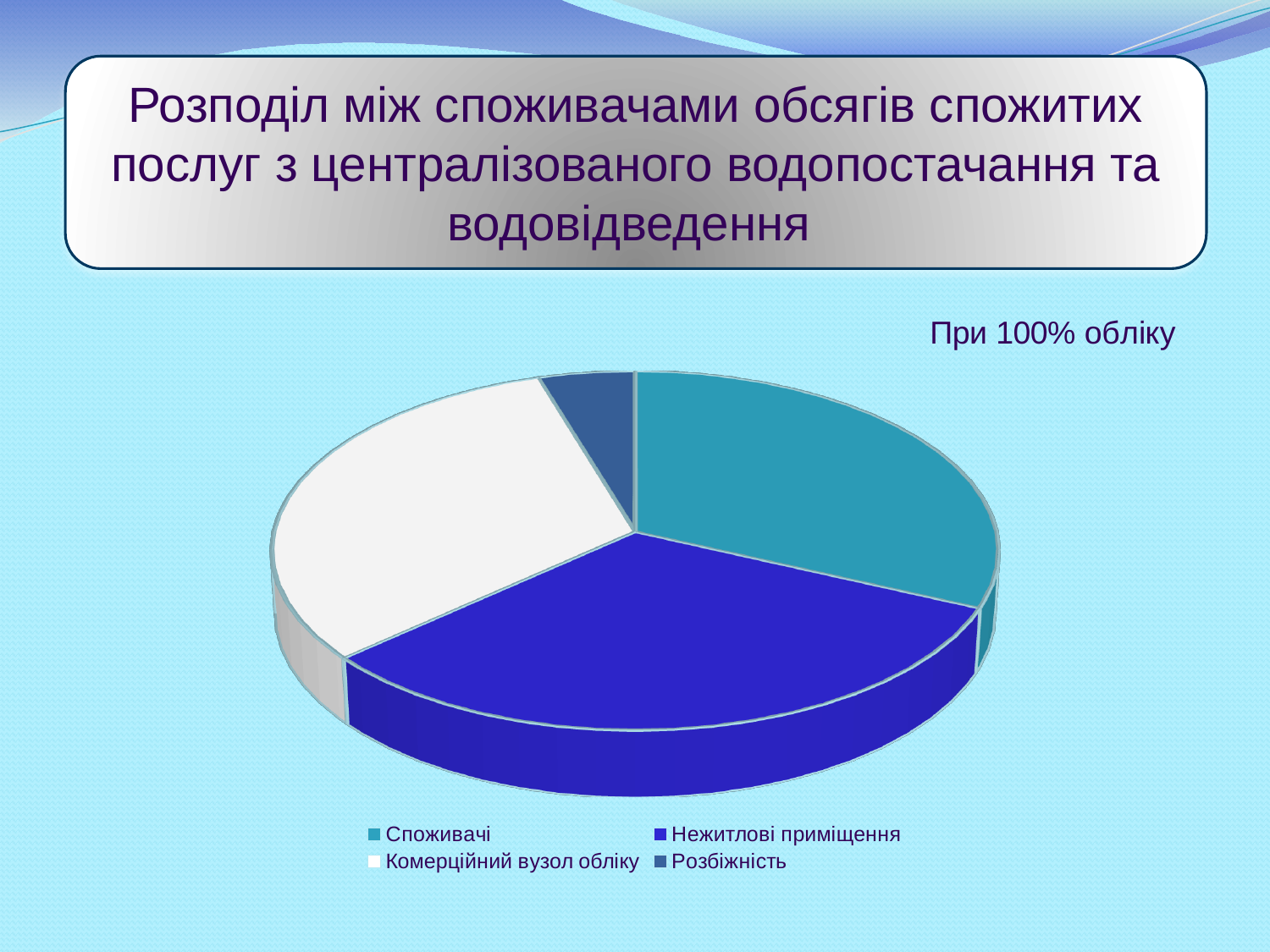
How many slices does the pie chart have? 4 How many entries does the legend of the pie chart list? 4 Which slice is larger: Споживачі or Розбіжність? Споживачі What colour is the Комерційний вузол обліку slice in the pie chart? white Which slice is larger: Комерційний вузол обліку or Розбіжність? Комерційний вузол обліку What kind of chart is shown on the slide? pie chart Which category has the smallest slice in the pie chart? Розбіжність Which slice is larger: Нежитлові приміщення or Розбіжність? Нежитлові приміщення What text appears above the pie chart on the right side of the slide? При 100% обліку